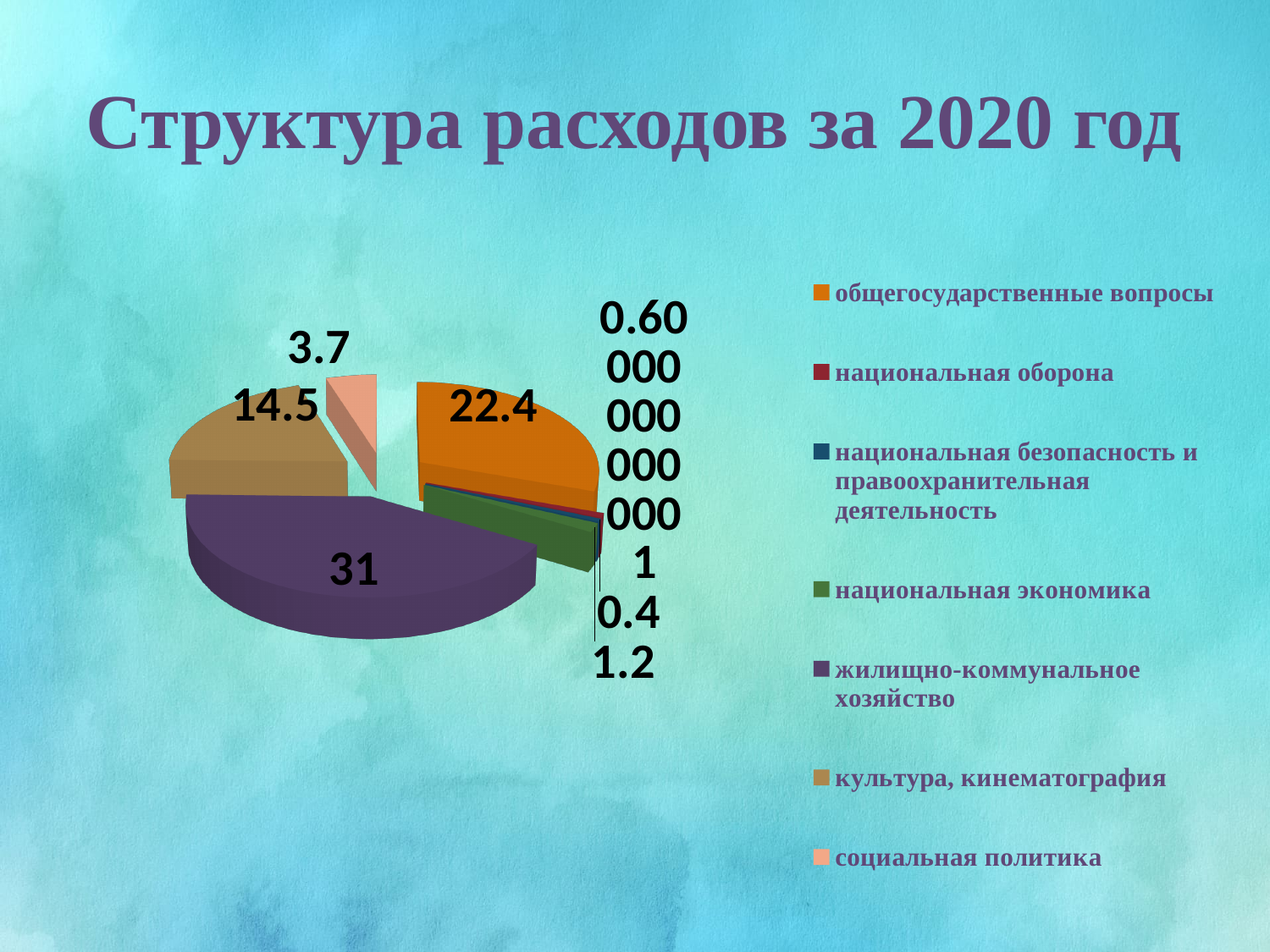
What is the difference between the values for жилищно-коммунальное хозяйство and общегосударственные вопросы? 8.6 How many categories does the legend of the pie chart list? 7 What is the value shown for общегосударственные вопросы? 22.4 What is the value shown for социальная политика? 3.7 Which is larger: общегосударственные вопросы or культура, кинематография? общегосударственные вопросы What type of chart is shown on the slide? pie chart What is the value shown for культура, кинематография? 14.5 Which category has the largest slice of the pie? жилищно-коммунальное хозяйство What is the title of the chart on the slide? Структура расходов за 2020 год What colour is the slice for жилищно-коммунальное хозяйство? purple What is the value shown for жилищно-коммунальное хозяйство? 31 What is the difference between the values for культура, кинематография and социальная политика? 10.8